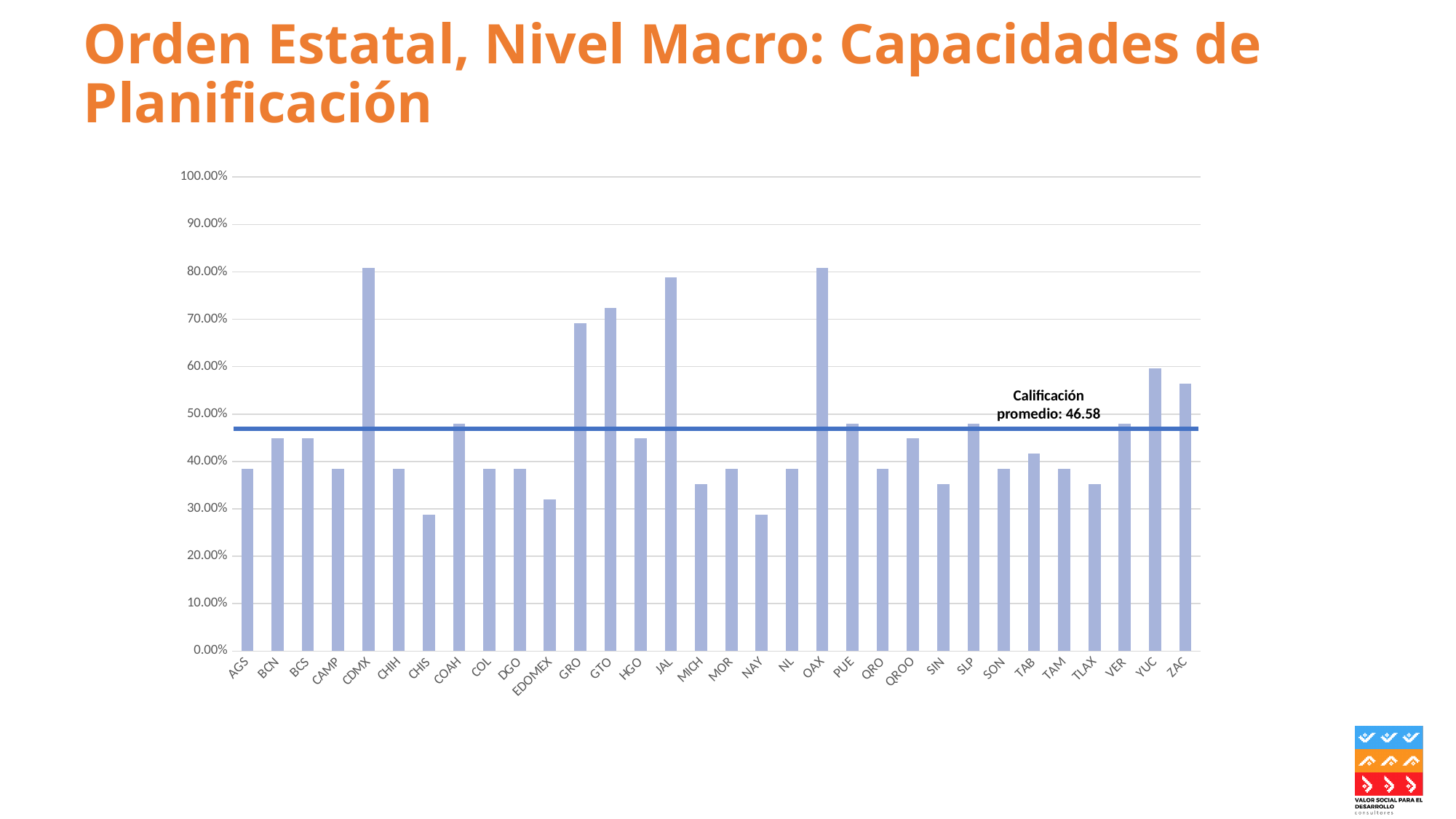
Is the value for JAL greater or less than 70.00%? greater Which has the larger value, CDMX or AGS? CDMX Is the value for EDOMEX greater or less than 40.00%? less Which has the larger value, GRO or EDOMEX? GRO Is the value for CHIS greater or less than 40.00%? less What average score (Calificación promedio) is annotated on the horizontal line in the chart? 46.58 How many states (categories) are plotted along the x axis? 32 What is the title of the slide containing the chart? Orden Estatal, Nivel Macro: Capacidades de Planificación What kind of chart is shown on the slide? bar chart Which has the larger value, JAL or HGO? JAL